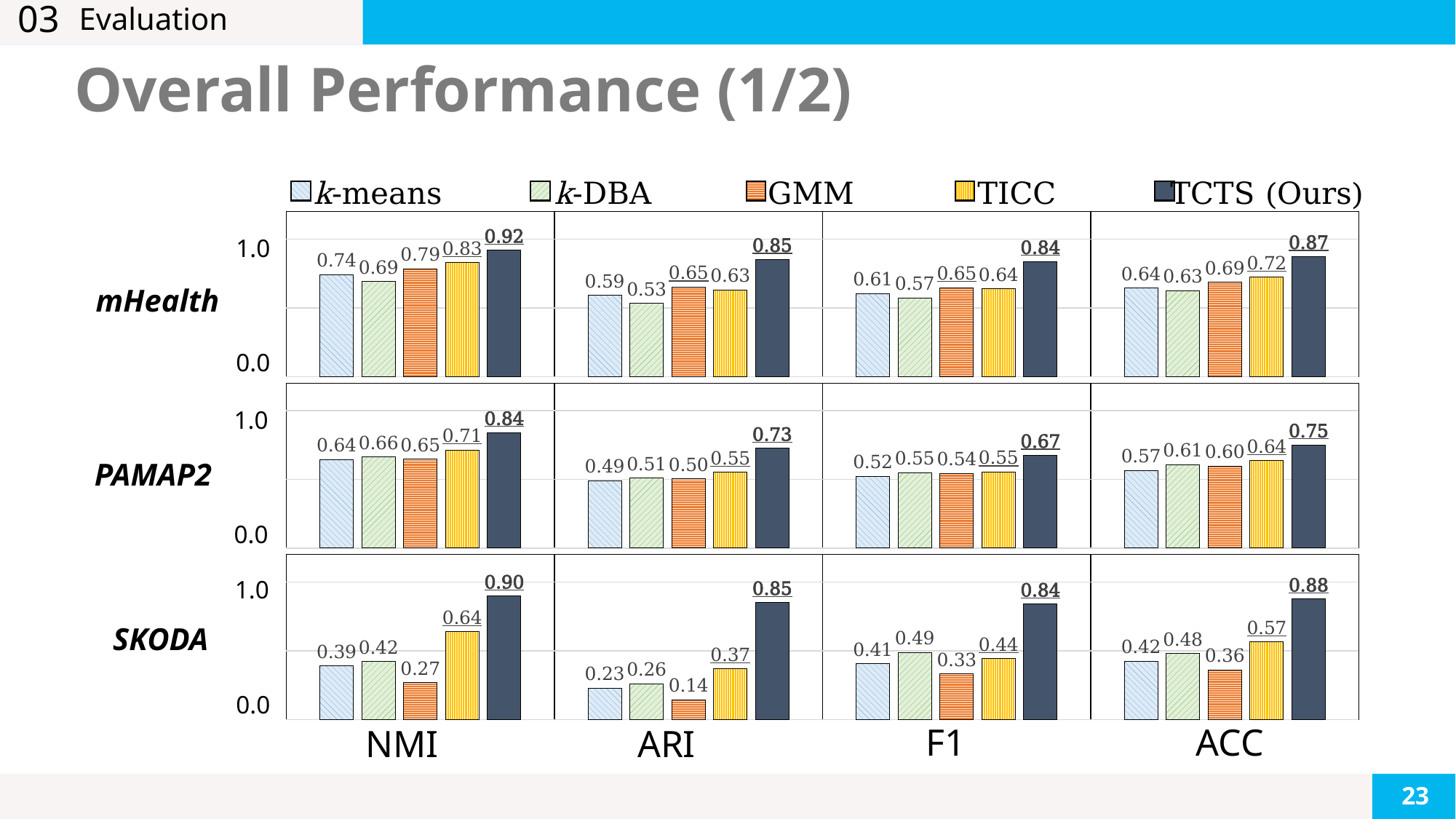
How many datasets (rows of charts) are shown on the slide? 3 How many methods does the legend list? 5 What kind of chart is used in each panel of the slide? bar chart In the SKODA NMI chart, how much higher is TCTS (Ours) than TICC? 0.26 In the PAMAP2 ARI chart, what is the value for TICC? 0.55 In the SKODA ARI chart, is the value for k-means greater or less than 0.5? less In the mHealth ACC chart, what is the difference between the TCTS (Ours) value and the TICC value? 0.15 In the SKODA ARI chart, what is the value for GMM? 0.14 In the PAMAP2 NMI chart, which is larger, the k-means value or the k-DBA value? k-DBA In the PAMAP2 ACC chart, which method has the highest value? TCTS (Ours) In the SKODA F1 chart, which method has the lowest value? GMM In the mHealth NMI chart, what is the value for TCTS (Ours)? 0.92